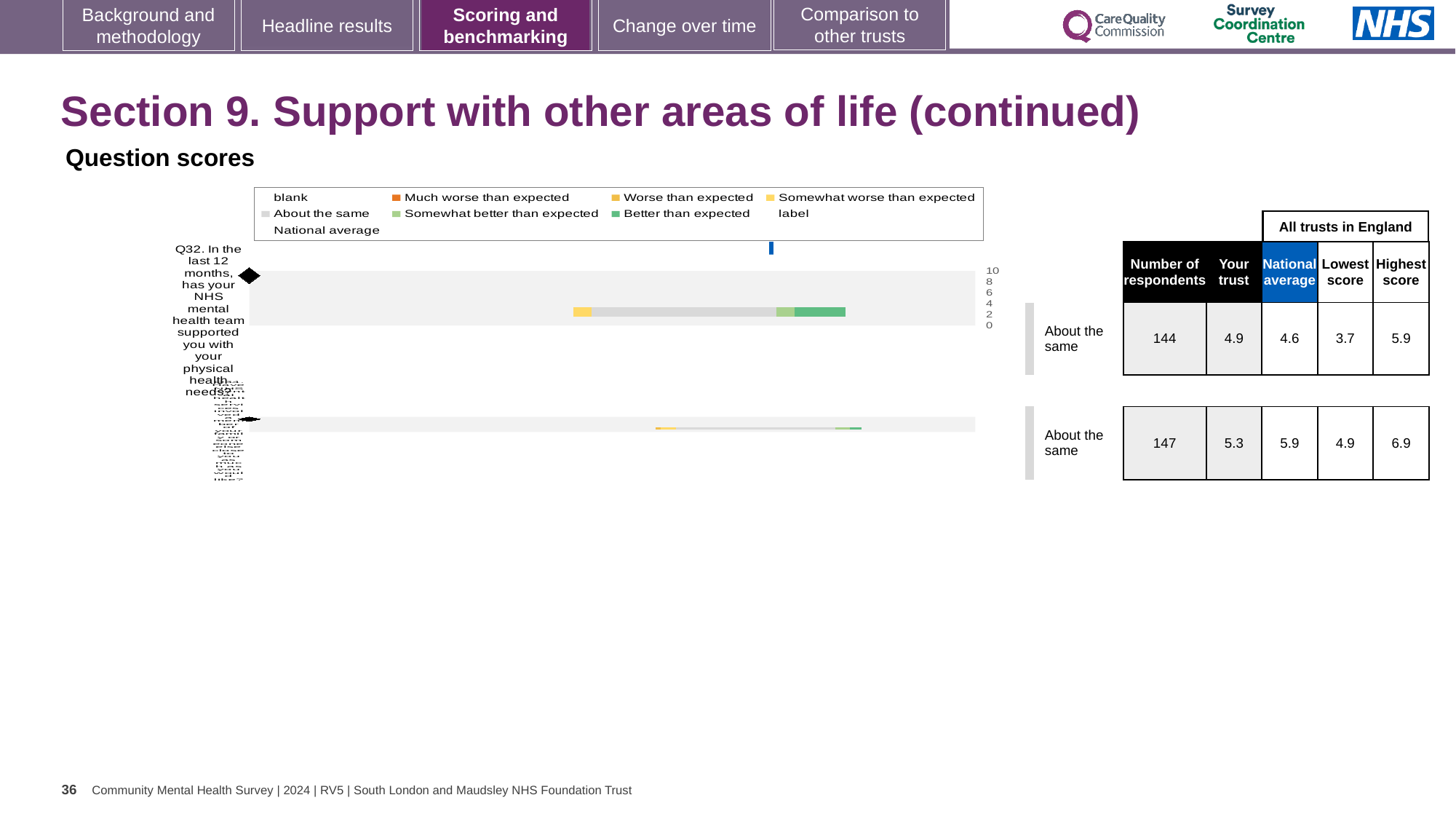
For Q32, which is larger: the trust's own score or the national average? Your trust (4.9) What is the 'Your trust' score for Q32 in the table? 4.9 For Q32 (support with physical health needs), how many respondents are shown in the table? 144 What kind of chart is used to show the question scores on this slide? Bar chart For Q32, how much higher is the trust's score than the national average? 0.3 What is the national average score for Q32? 4.6 What benchmark category is shown next to the Q32 bar? About the same How many question rows are plotted in the chart? 2 What is the highest score among all trusts in England for Q32? 5.9 For Q32, what is the difference between the highest score and the lowest score across all trusts in England? 2.2 What is the lowest score among all trusts in England for Q32? 3.7 Is the trust's score for Q32 greater or less than 4 on the chart's axis? greater